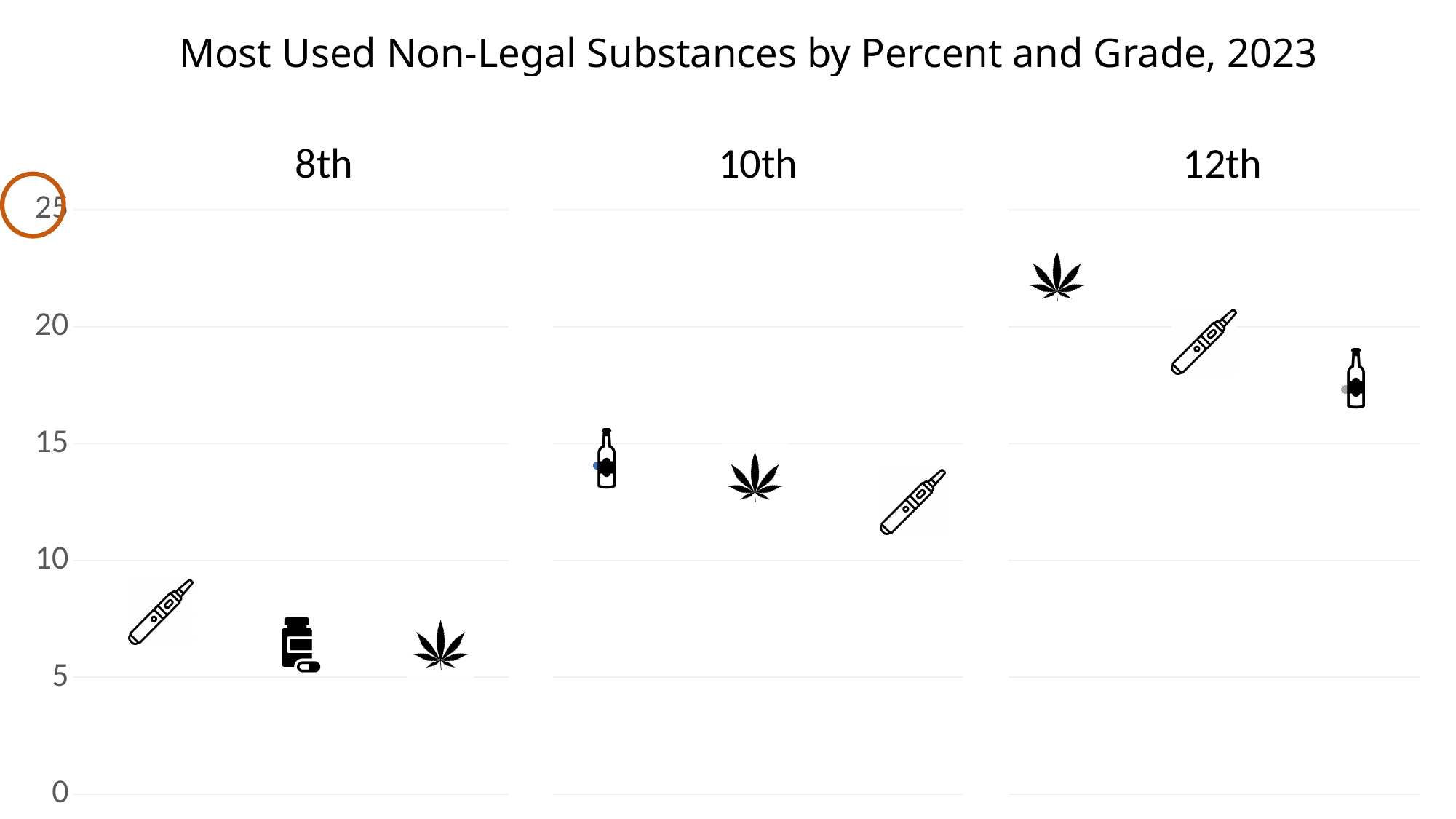
In the 8th grade panel, is the value for the vape icon greater or less than 10? less In the 12th grade panel, is the value for the alcohol bottle icon greater or less than 20? less Does the cannabis leaf value rise or fall from the 8th grade panel to the 12th grade panel? rise In the 10th grade panel, is the value for the alcohol bottle icon greater or less than 10? greater What is the title of the chart? Most Used Non-Legal Substances by Percent and Grade, 2023 Is the cannabis leaf value higher in the 12th grade panel or the 8th grade panel? 12th grade How many substance icons are plotted in the 8th grade panel? 3 In the 12th grade panel, which substance icon is plotted highest? cannabis leaf How many substance icons are plotted across all three grade panels? 9 Which three grade levels are shown as panels in the chart? 8th, 10th, 12th In the 8th grade panel, which substance icon is plotted highest? vape